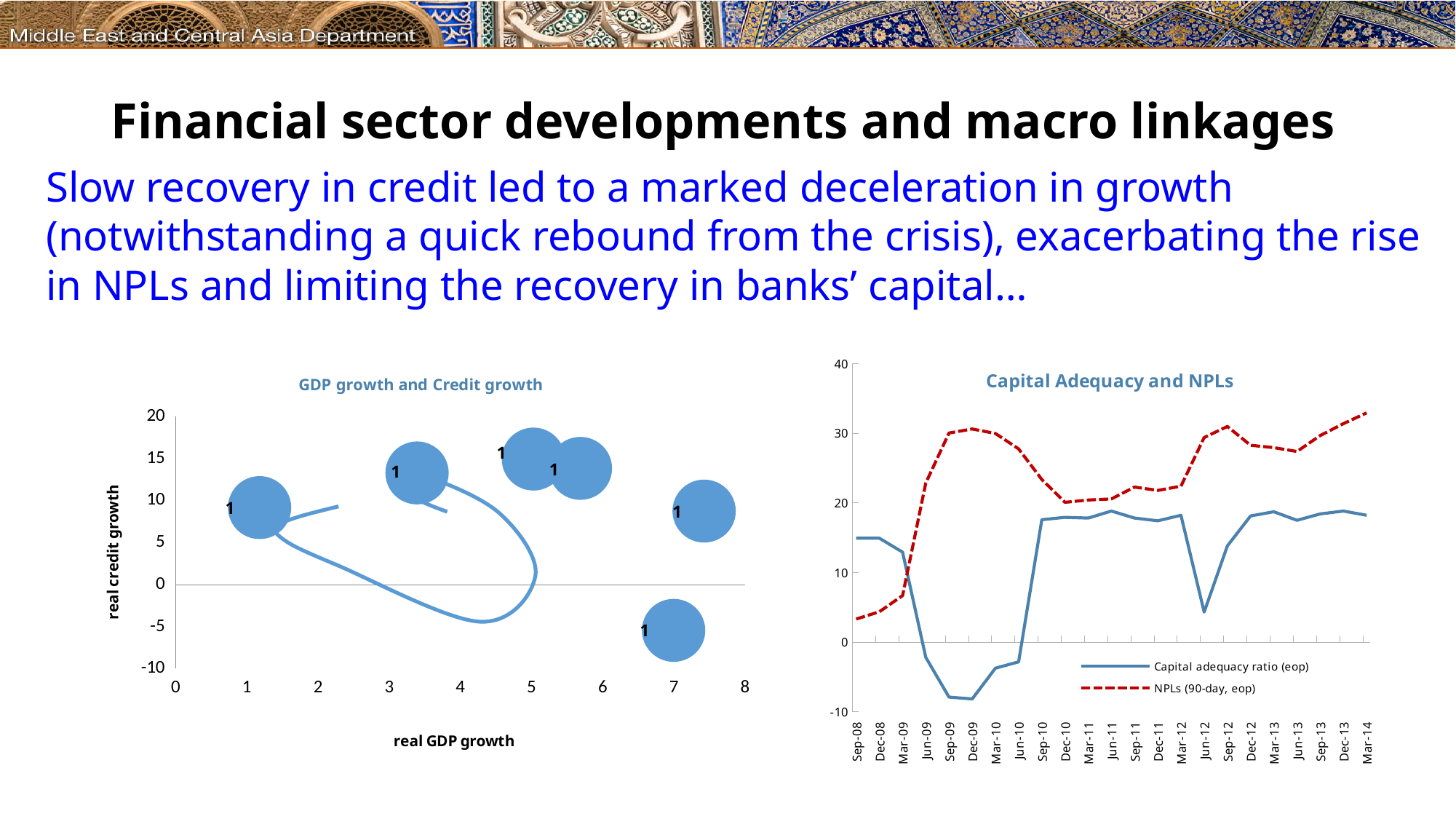
What type of chart is the 'Capital Adequacy and NPLs' chart? line chart In the 'Capital Adequacy and NPLs' chart, is the Capital adequacy ratio (eop) at Jun-12 greater or less than 10? less What is the x-axis title of the 'GDP growth and Credit growth' chart? real GDP growth In the 'Capital Adequacy and NPLs' chart, is the Capital adequacy ratio (eop) at Dec-09 greater or less than 0? less In the 'Capital Adequacy and NPLs' chart, does the NPLs (90-day, eop) series overall rise or fall from Sep-08 to Mar-14? rise How many series does the legend of the 'Capital Adequacy and NPLs' chart list? 2 In the 'Capital Adequacy and NPLs' chart, which series is drawn with a red dashed line? NPLs (90-day, eop) In the 'Capital Adequacy and NPLs' chart, which series has the higher value at Mar-14? NPLs (90-day, eop) In the 'Capital Adequacy and NPLs' chart, which series has the higher value at Sep-08? Capital adequacy ratio (eop) In the 'Capital Adequacy and NPLs' chart, is the NPLs (90-day, eop) value at Mar-14 greater or less than 30? greater How many bubbles are plotted in the 'GDP growth and Credit growth' chart? 6 In the 'Capital Adequacy and NPLs' chart, at which date does the NPLs (90-day, eop) series reach its highest value? Mar-14